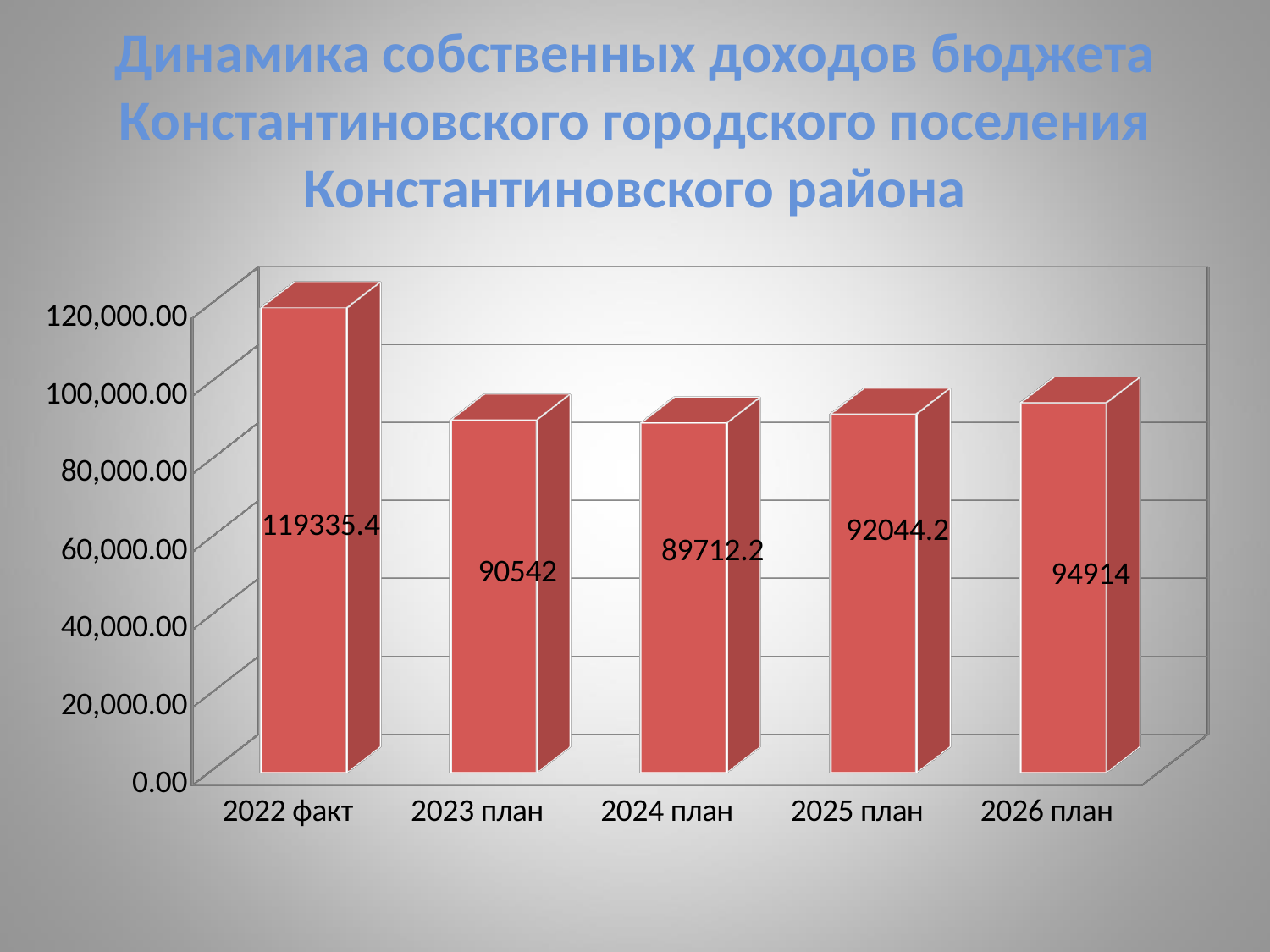
Which category has the lowest value? 2024 план How many categories are shown on the x axis? 5 Which category has the highest value? 2022 факт What is the value for 2022 факт? 119335.4 What is the difference between the values for 2026 план and 2025 план? 2869.8 What is the value for 2026 план? 94914 Which is larger, the value for 2025 план or the value for 2024 план? 2025 план What kind of chart is shown on the slide? bar chart Is the value for 2022 факт greater or less than 100,000.00? greater What is the difference between the values for 2022 факт and 2023 план? 28793.4 What is the value for 2024 план? 89712.2 Do the values rise or fall from 2024 план to 2026 план? rise